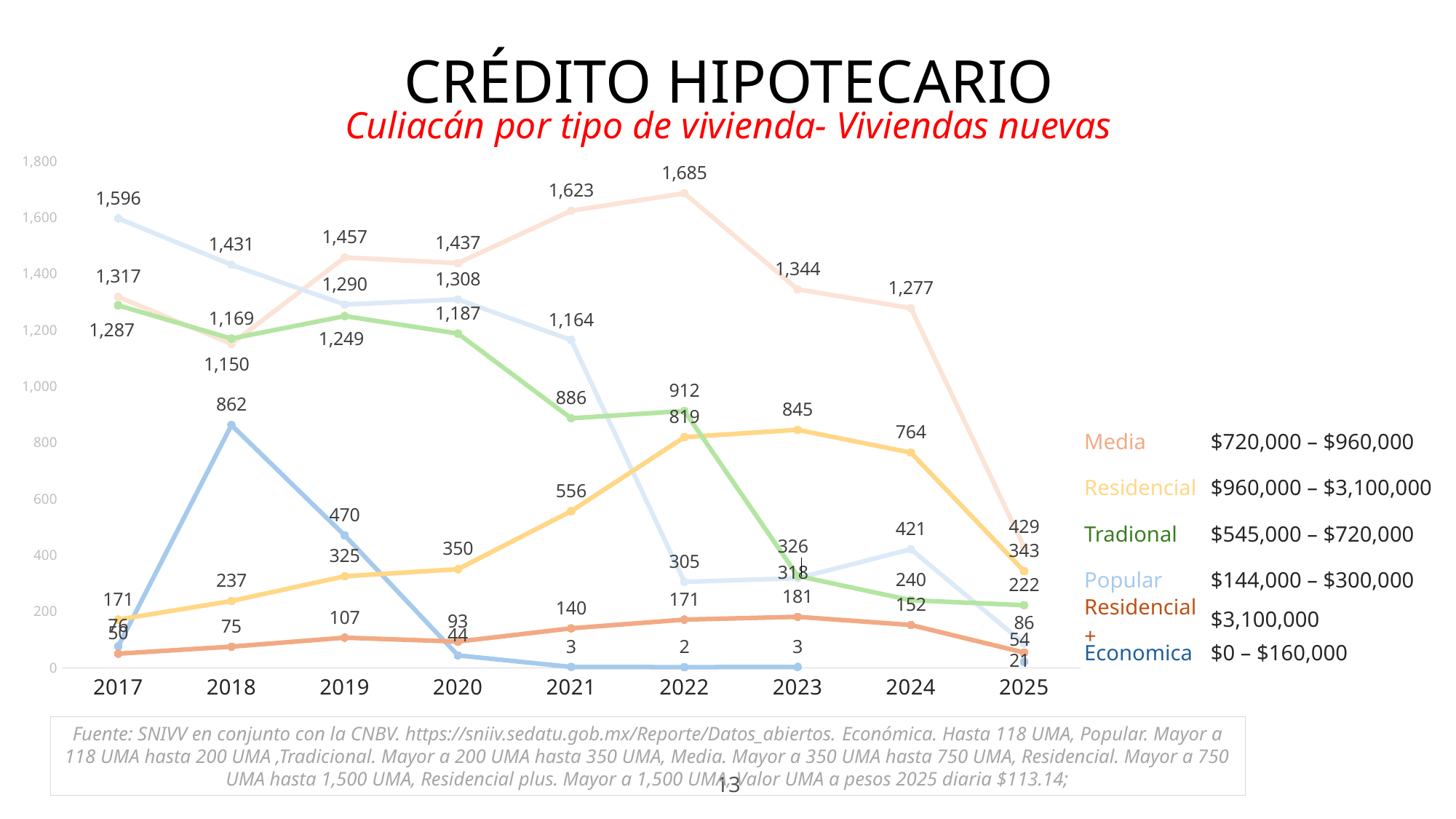
How many series does the legend list? 6 What is the value for the Residencial series in 2023? 845 In which year does the Media series reach its highest value? 2022 What is the value for the Media series in 2022? 1,685 How many years are shown on the x axis of the chart? 9 In 2017, which is larger: the Popular value or the Media value? Popular What is the value for the Popular series in 2017? 1,596 What price range does the legend give for the Media category? $720,000 – $960,000 What is the difference between the Media values in 2022 and 2023? 341 Does the Residencial series rise or fall from 2017 to 2023? rise What is the value for the Economica series in 2018? 862 What kind of chart is shown on the slide? line chart